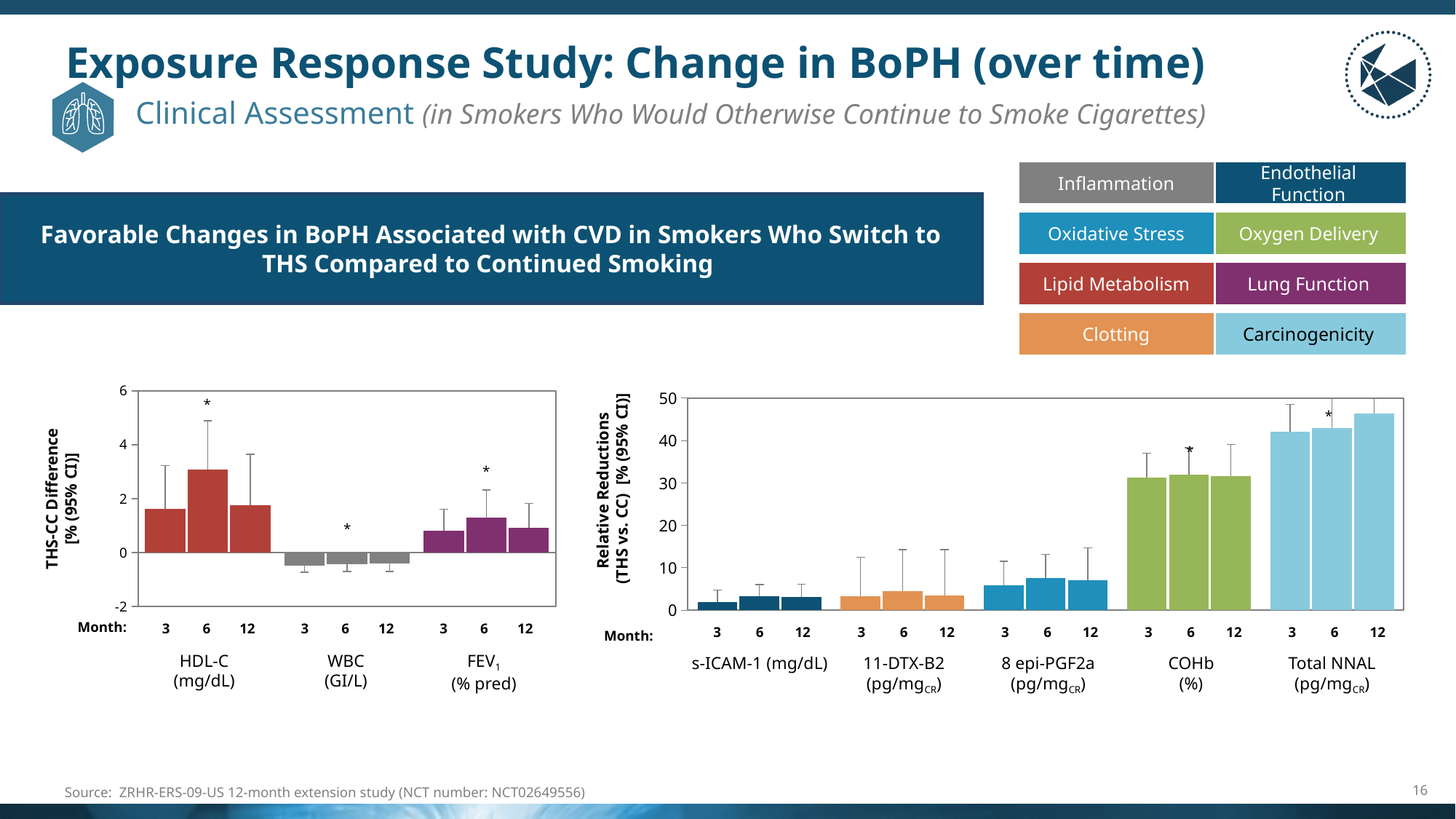
In the right chart (Relative Reductions), do the Total NNAL values rise or fall from month 3 to month 12? rise In the right chart (Relative Reductions), which biomarker and month has the highest bar? Total NNAL, month 12 In the left chart (THS-CC Difference), which biomarker and month has the highest bar? HDL-C, month 6 In the right chart (Relative Reductions), is the value for 8 epi-PGF2a at month 6 greater or less than 10? less In the right chart (Relative Reductions), is the value for Total NNAL at month 3 greater or less than 40? greater In the left chart (THS-CC Difference), is the value for FEV1 at month 6 greater or less than 2? less What type of chart is the left chart (THS-CC Difference)? bar chart In the right chart (Relative Reductions), which biomarker and month has the lowest bar? s-ICAM-1, month 3 How many biomarkers are shown on the x axis of the left chart (THS-CC Difference)? 3 In the right chart (Relative Reductions), which is larger at month 3: COHb or 8 epi-PGF2a? COHb